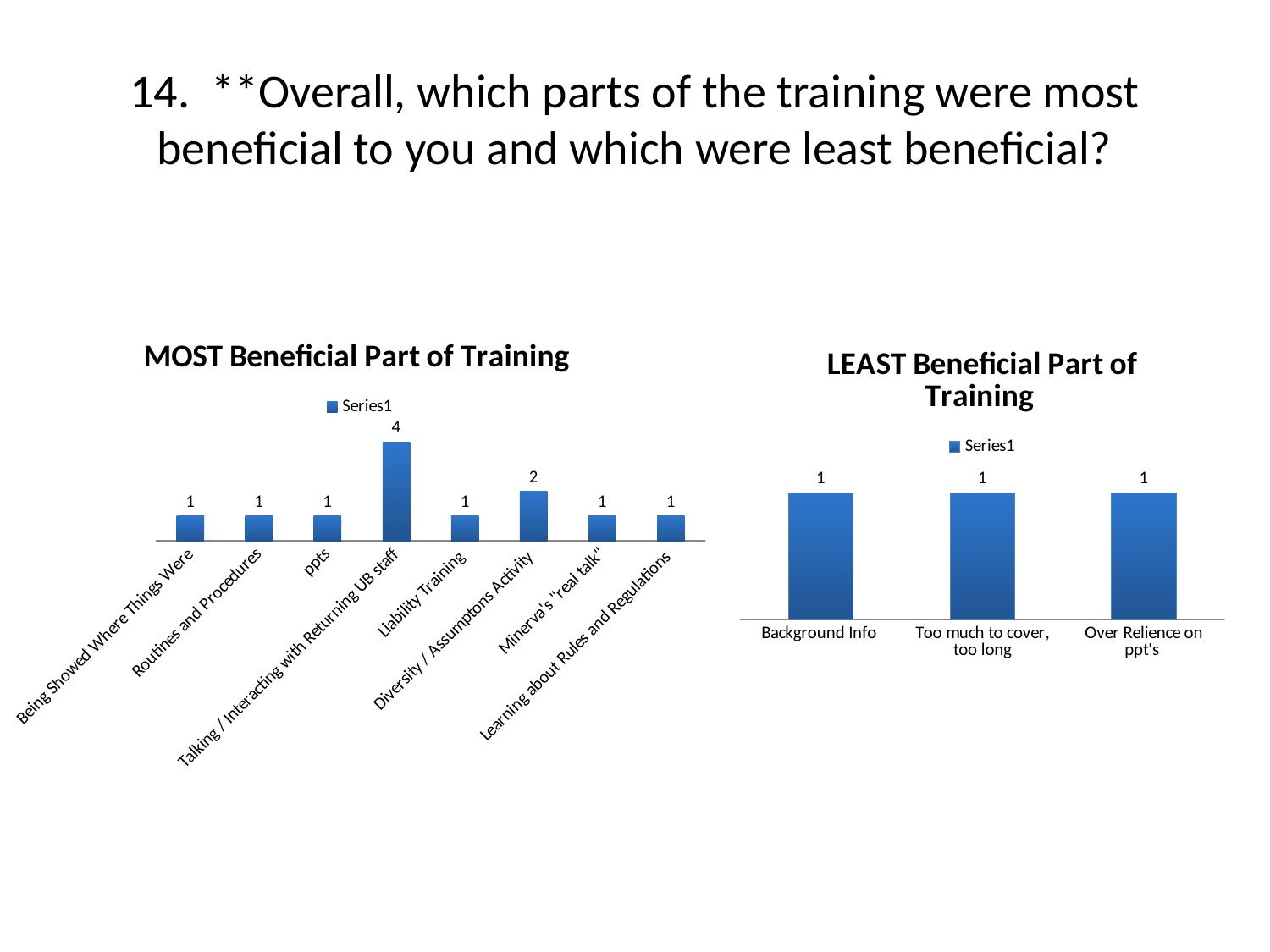
In the 'MOST Beneficial Part of Training' chart, what is the difference between 'Talking / Interacting with Returning UB staff' and 'Diversity / Assumptons Activity'? 2 What is the legend entry shown in the 'LEAST Beneficial Part of Training' chart? Series1 How many categories are shown in the 'LEAST Beneficial Part of Training' chart? 3 In the 'LEAST Beneficial Part of Training' chart, what is the value for 'Background Info'? 1 How many categories are shown in the 'MOST Beneficial Part of Training' chart? 8 In the 'MOST Beneficial Part of Training' chart, what is the value for 'Diversity / Assumptons Activity'? 2 In the 'MOST Beneficial Part of Training' chart, which is larger: 'Diversity / Assumptons Activity' or 'ppts'? Diversity / Assumptons Activity In the 'MOST Beneficial Part of Training' chart, what is the value for 'Talking / Interacting with Returning UB staff'? 4 In the 'MOST Beneficial Part of Training' chart, what is the value for 'Liability Training'? 1 In the 'MOST Beneficial Part of Training' chart, which category has the highest value? Talking / Interacting with Returning UB staff How many series does the legend of the 'MOST Beneficial Part of Training' chart list? 1 What kind of chart is the 'LEAST Beneficial Part of Training' chart? Bar chart